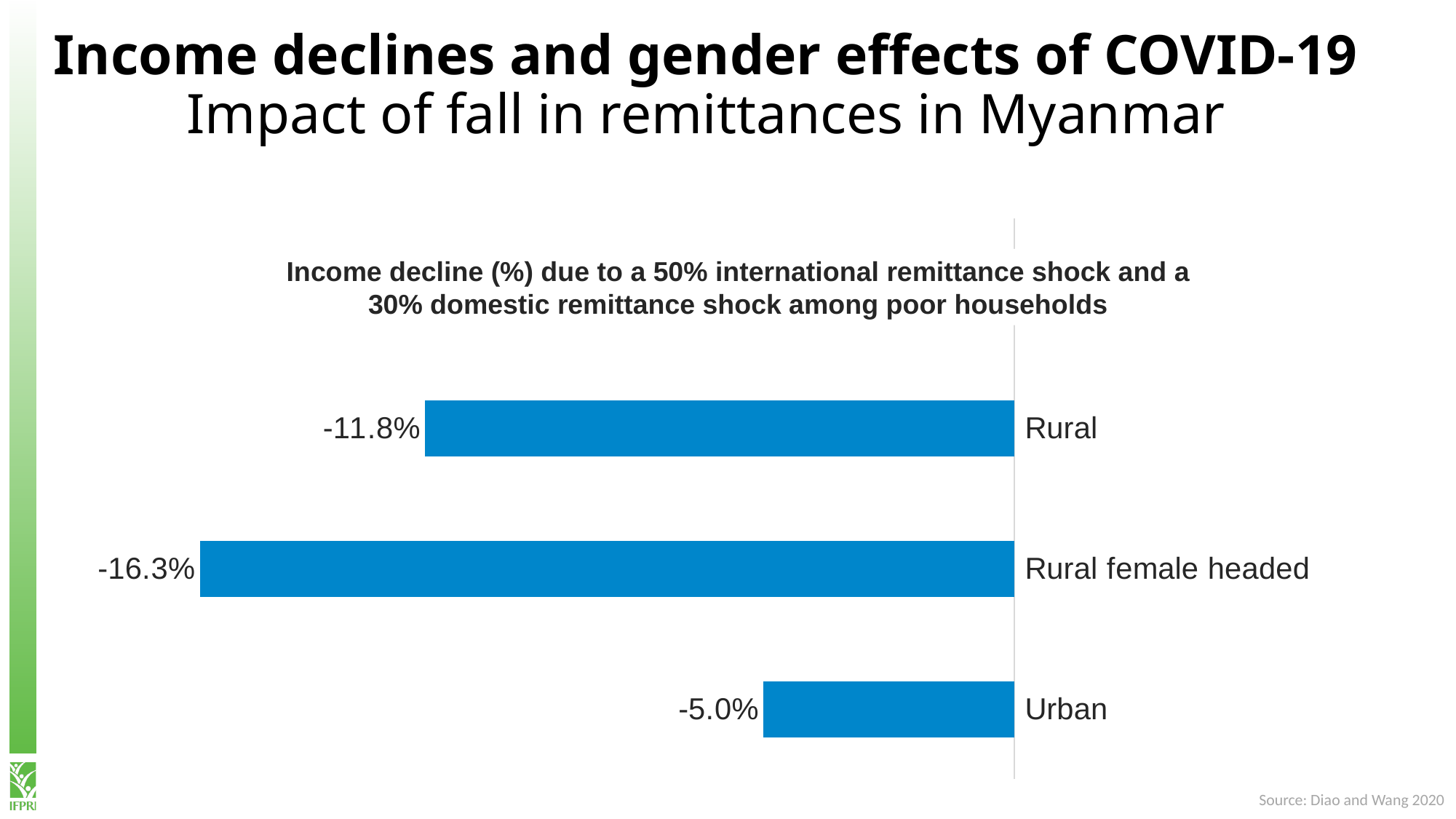
Which category shows the smallest income decline? Urban How many categories are shown in the chart? 3 What type of chart is shown on the slide? Bar chart What is the income decline for Rural households? -11.8% Which category shows the largest income decline? Rural female headed What is the income decline for Rural female headed households? -16.3% What is the difference in percentage points between the income decline for Rural female headed and Rural households? 4.5 percentage points What is the title of the chart? Income decline (%) due to a 50% international remittance shock and a 30% domestic remittance shock among poor households What is the difference in percentage points between the income decline for Rural and Urban households? 6.8 percentage points Which has a larger income decline, Rural or Urban households? Rural What is the income decline for Urban households? -5.0% What colour are the bars in the chart? Blue